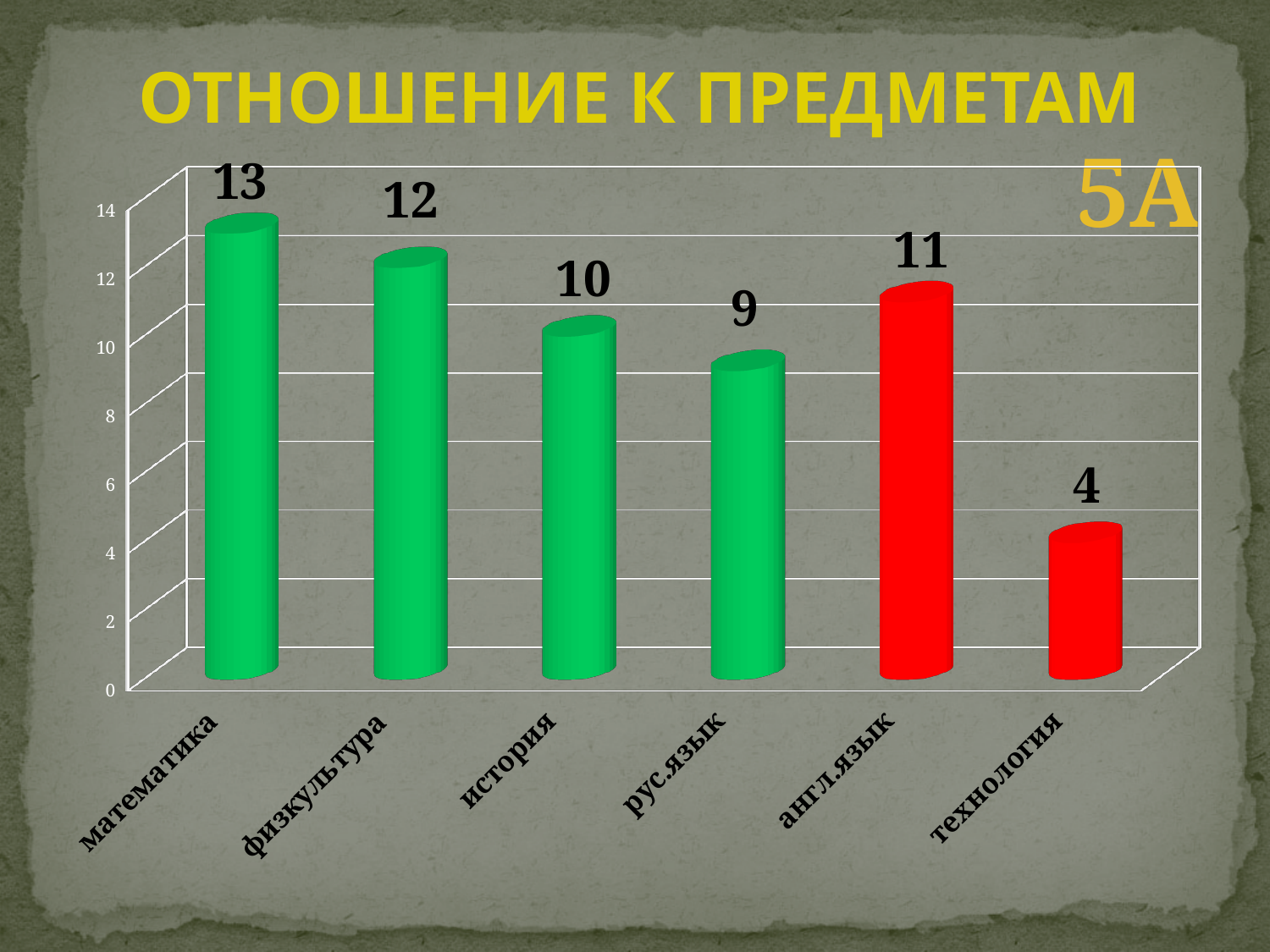
What is the value for математика? 13 Which category has the lowest value? технология What is the value for технология? 4 What is the difference between the values for физкультура and рус.язык? 3 Is the value for рус.язык greater or less than 10? less What is the value for англ.язык? 11 Which category has the highest value? математика What is the title of the slide? ОТНОШЕНИЕ К ПРЕДМЕТАМ What kind of chart is shown on the slide? bar chart Which is larger, the value for история or the value for англ.язык? англ.язык How many categories are shown on the chart? 6 What colour are the bars for англ.язык and технология? red